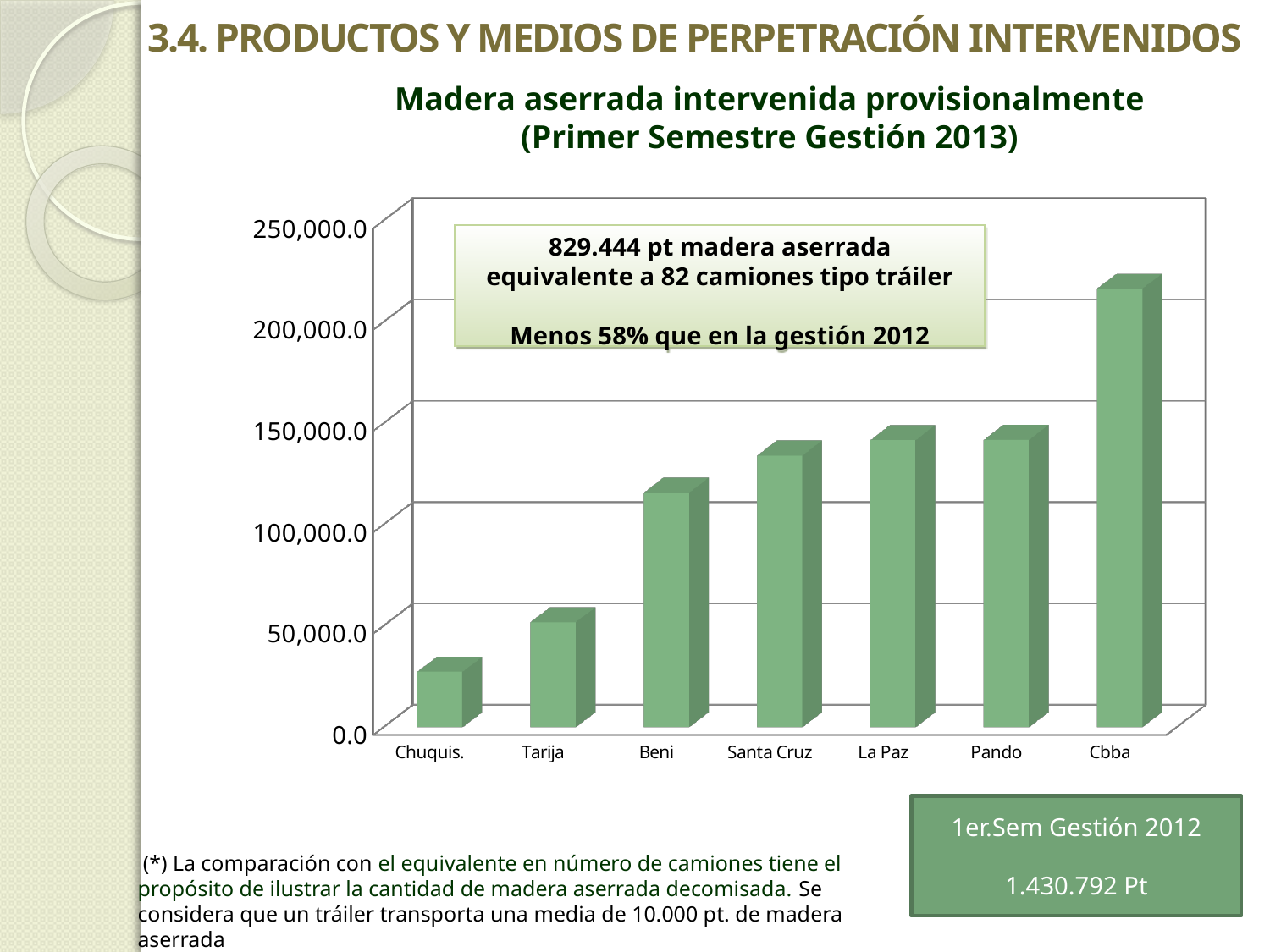
Do the bar values generally rise or fall from left to right along the x axis? rise Which category has the highest bar in the chart? Cbba What kind of chart is shown on the slide? bar chart What is the title of the chart? Madera aserrada intervenida provisionalmente (Primer Semestre Gestión 2013) How many categories (departments) are shown on the x axis of the chart? 7 Is the value for Cbba greater or less than 200,000.0? greater Which is larger, the value for Santa Cruz or the value for Tarija? Santa Cruz Is the value for Chuquis. greater or less than 50,000.0? less Which is larger, the value for Cbba or the value for Beni? Cbba Is the value for Santa Cruz greater or less than 150,000.0? less Which category has the lowest bar in the chart? Chuquis.